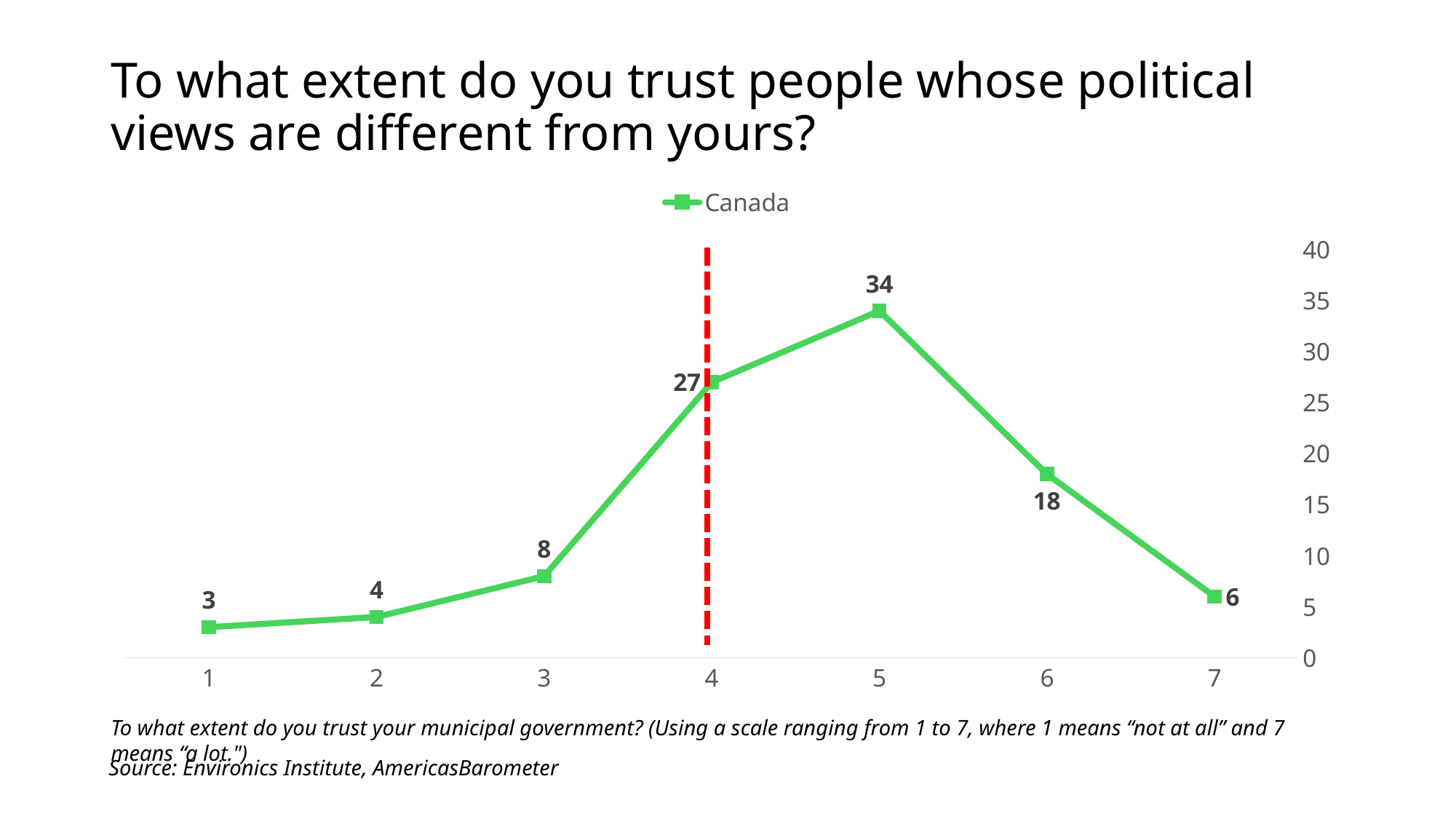
What is the value for scale point 1 in the Canada series? 3 How many series does the legend list? 1 Do the values rise or fall from scale point 5 to scale point 7? fall Which scale point has the lowest value? 1 Which scale point has the highest value? 5 What is the difference between the values for scale points 5 and 4? 7 What kind of chart is shown on the slide? line chart What is the value for scale point 5 in the Canada series? 34 Which has a larger value, scale point 3 or scale point 7? 3 What is the difference between the values for scale points 6 and 7? 12 How many scale points are plotted on the x axis? 7 What is the value for scale point 6 in the Canada series? 18